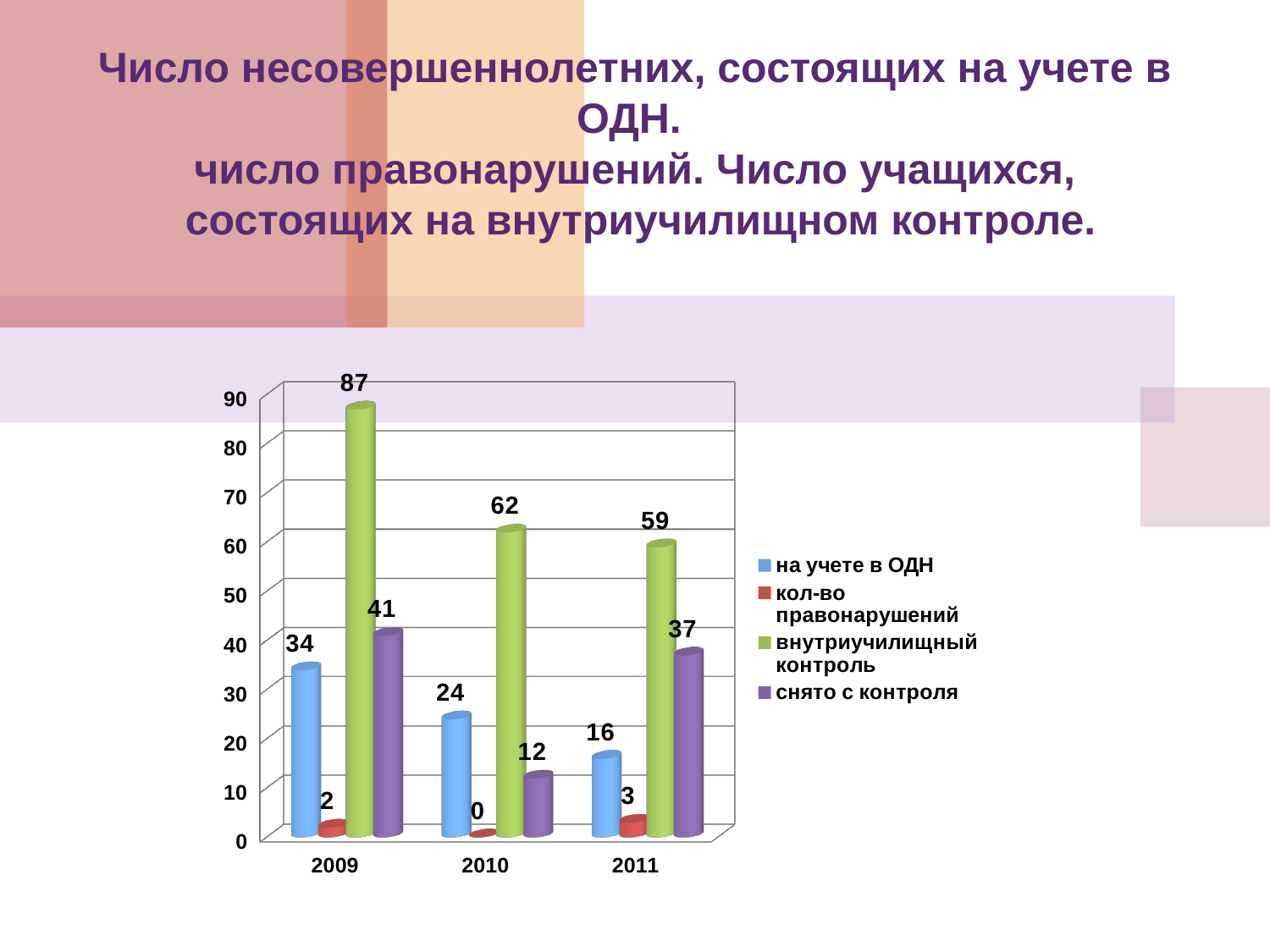
What is the difference between "внутриучилищный контроль" in 2009 and 2011? 28 In which year is "на учете в ОДН" lowest? 2011 What is the value for "снято с контроля" in 2011? 37 In which year is "внутриучилищный контроль" highest? 2009 What kind of chart is shown on the slide? bar chart Does the value for "на учете в ОДН" rise or fall from 2009 to 2011? fall How many years are shown on the x axis? 3 How many series does the legend list? 4 What is the value for "внутриучилищный контроль" in 2010? 62 Which is larger: "снято с контроля" in 2009 or in 2010? 2009 What is the value for "кол-во правонарушений" in 2010? 0 What is the value for "на учете в ОДН" in 2009? 34